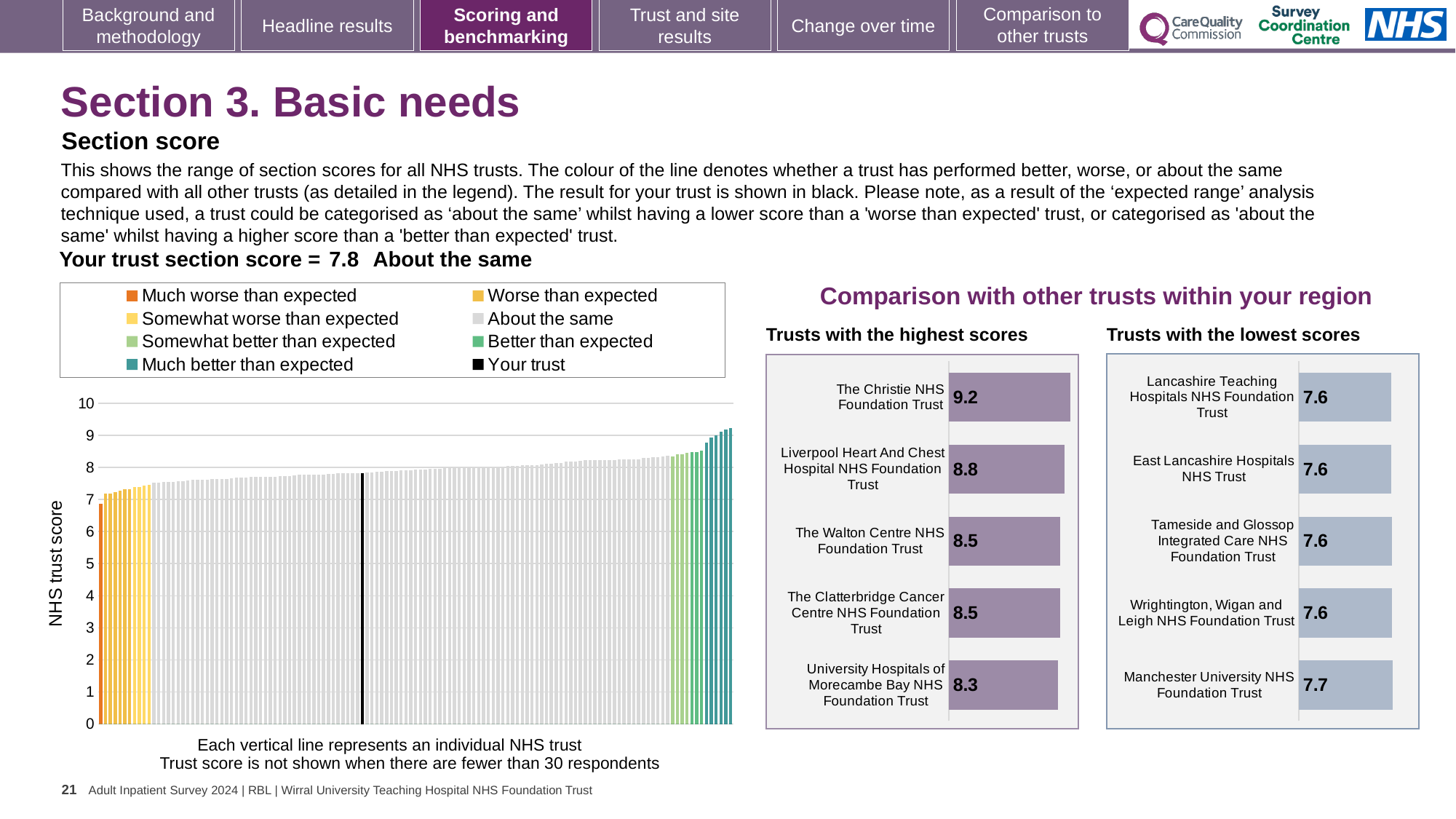
In the 'Trusts with the highest scores' chart, how many trusts are shown? 5 In the 'Trusts with the highest scores' chart, which trust has the highest score? The Christie NHS Foundation Trust In the 'Trusts with the highest scores' chart, what is the score for The Christie NHS Foundation Trust? 9.2 In the 'Trusts with the lowest scores' chart, which trust has the highest score? Manchester University NHS Foundation Trust Which is larger: the score for The Walton Centre NHS Foundation Trust in the highest-scores chart or the score for Manchester University NHS Foundation Trust in the lowest-scores chart? The Walton Centre NHS Foundation Trust In the main chart on the left showing all NHS trusts, is the value of the tallest bar greater or less than 8? greater In the main chart on the left showing all NHS trusts, what is the section score for your trust? 7.8 In the 'Trusts with the lowest scores' chart, what is the score for Manchester University NHS Foundation Trust? 7.7 In the main chart on the left showing all NHS trusts, how many entries does the legend list? 8 In the 'Trusts with the highest scores' chart, what is the difference between the scores of The Christie NHS Foundation Trust and Liverpool Heart And Chest Hospital NHS Foundation Trust? 0.4 In the 'Trusts with the highest scores' chart, what is the score for University Hospitals of Morecambe Bay NHS Foundation Trust? 8.3 In the 'Trusts with the lowest scores' chart, what is the score for East Lancashire Hospitals NHS Trust? 7.6